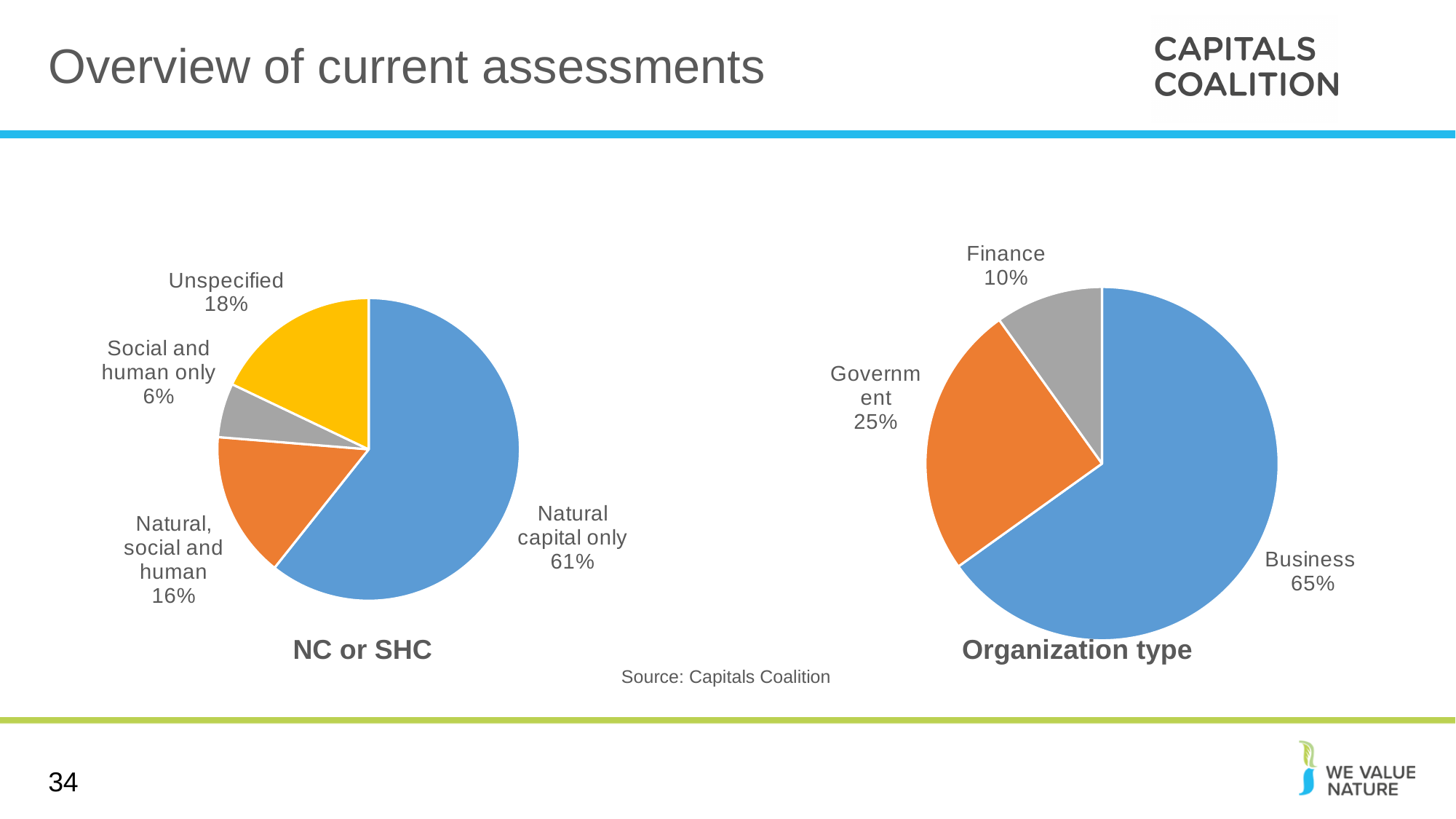
In the 'Organization type' chart, how many categories are shown? 3 In the 'NC or SHC' chart, what share is labelled for 'Unspecified'? 18% In the 'Organization type' chart, which category has the largest slice? Business In the 'NC or SHC' chart, which category has the smallest slice? Social and human only In the 'NC or SHC' chart, which is larger: 'Natural, social and human' or 'Social and human only'? Natural, social and human In the 'NC or SHC' chart, what share is labelled for 'Natural capital only'? 61% In the 'NC or SHC' chart, how many slices does the pie have? 4 What source is cited below the charts? Capitals Coalition In the 'NC or SHC' chart, what is the difference between the 'Unspecified' share and the 'Natural, social and human' share? 2% In the 'Organization type' chart, what is the difference between the 'Business' share and the 'Finance' share? 55% In the 'Organization type' chart, what share is labelled for 'Government'? 25% What type of chart is the 'Organization type' chart? Pie chart